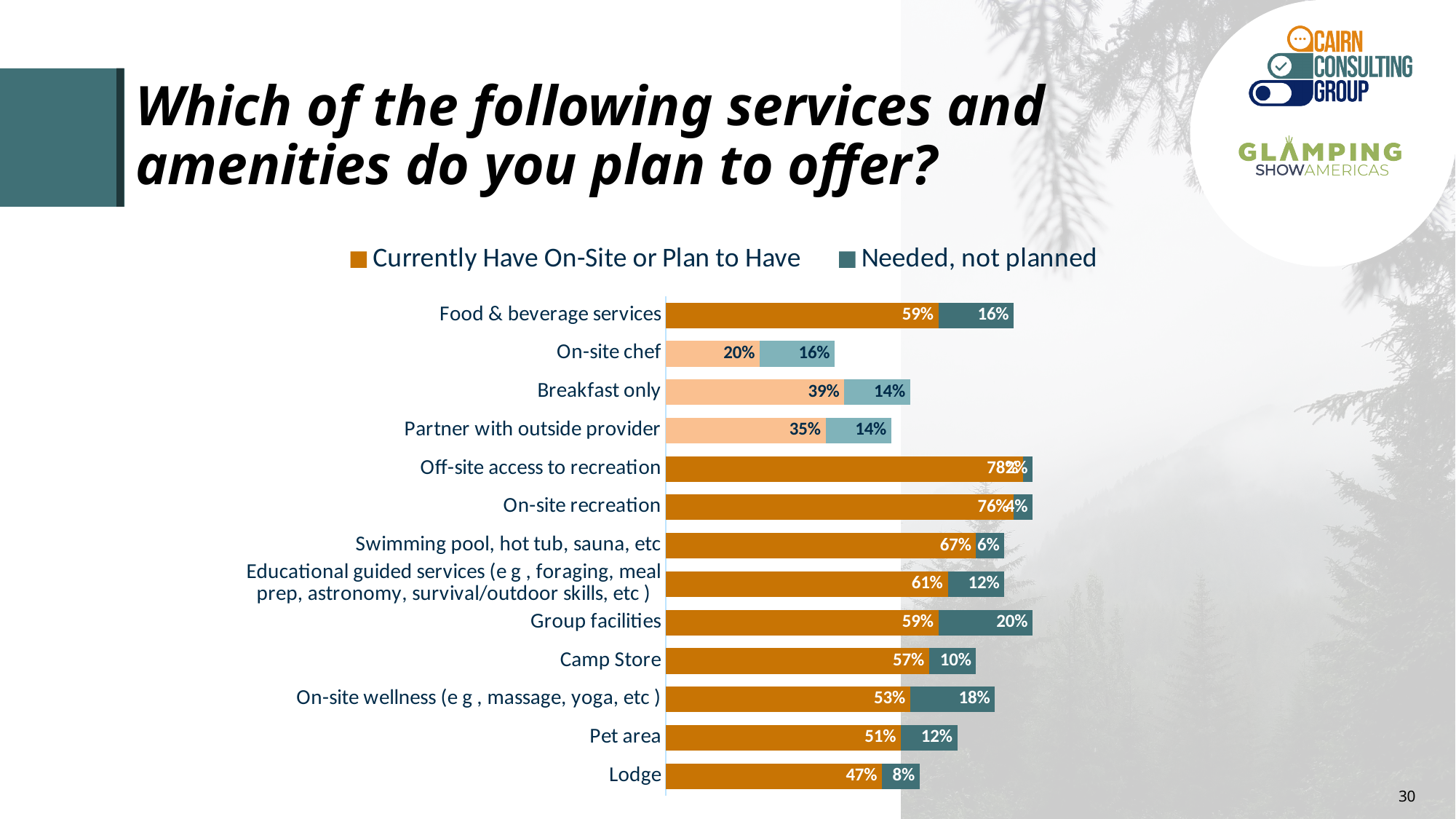
What is the difference between the 'Currently Have On-Site or Plan to Have' values for Breakfast only and Partner with outside provider? 4 percentage points How many series does the legend list? 2 Which category has the highest 'Needed, not planned' value? Group facilities Which has a larger 'Currently Have On-Site or Plan to Have' value, Camp Store or Pet area? Camp Store Which category has the lowest 'Currently Have On-Site or Plan to Have' value? On-site chef What is the total of the stacked bar for Lodge? 55% Which category has the highest 'Currently Have On-Site or Plan to Have' value? Off-site access to recreation What is the 'Currently Have On-Site or Plan to Have' value for Lodge? 47% How many categories are shown in the chart? 13 What is the 'Needed, not planned' value for Group facilities? 20% What percentage of respondents currently have on-site or plan to have Food & beverage services? 59% What kind of chart is shown on the slide? Stacked bar chart